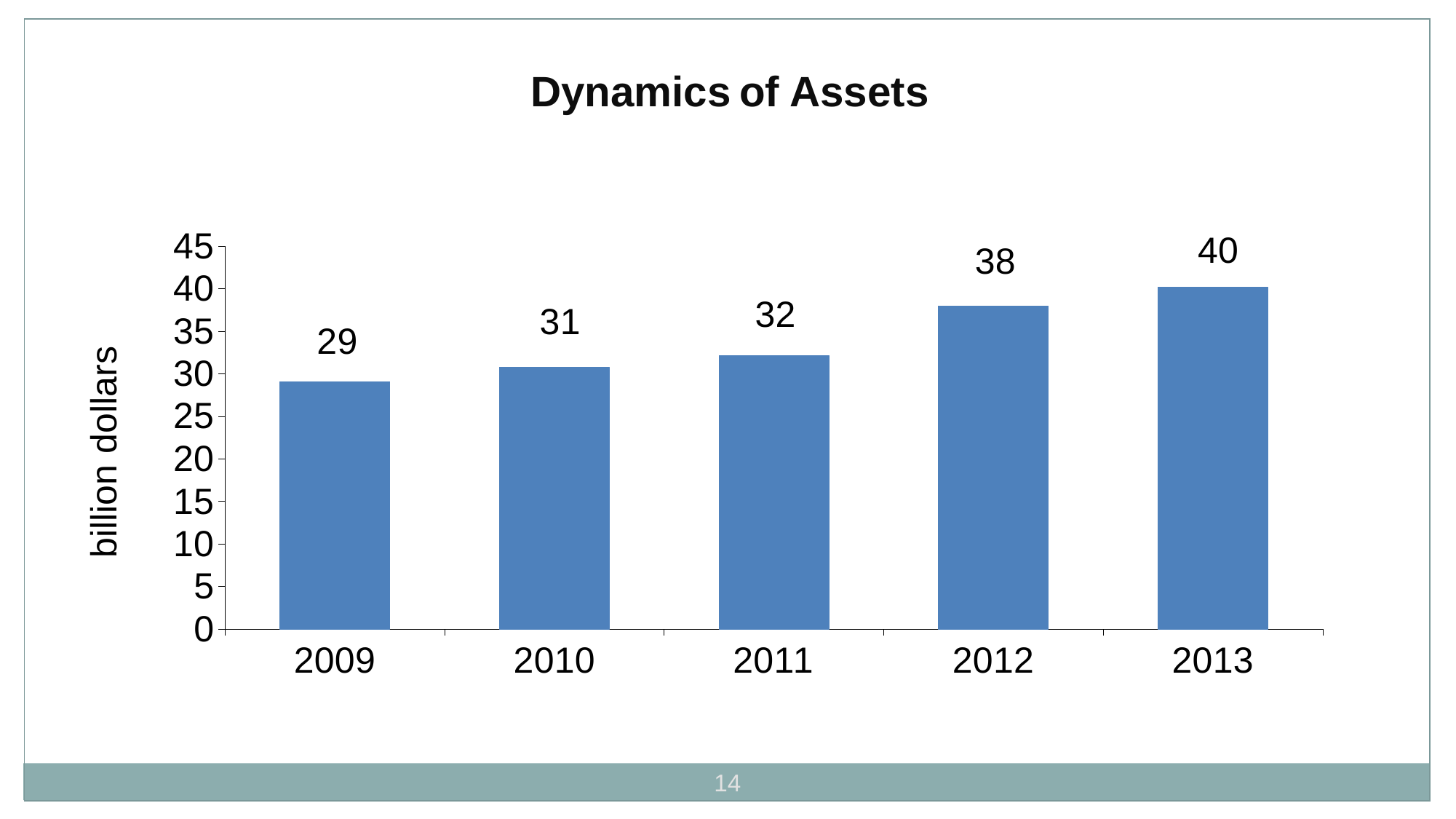
What is the value for 2013? 40 What is the value for 2012? 38 What kind of chart is shown on the slide? bar chart Which year has the highest value? 2013 What is the value for 2009? 29 Which is larger, the value for 2010 or the value for 2012? 2012 Is the value for 2011 greater or less than 35? less Do the values rise or fall from 2009 to 2013? rise What is the difference between the values for 2012 and 2011? 6 How many years are shown on the x axis? 5 Which year has the lowest value? 2009 What is the difference between the values for 2013 and 2009? 11